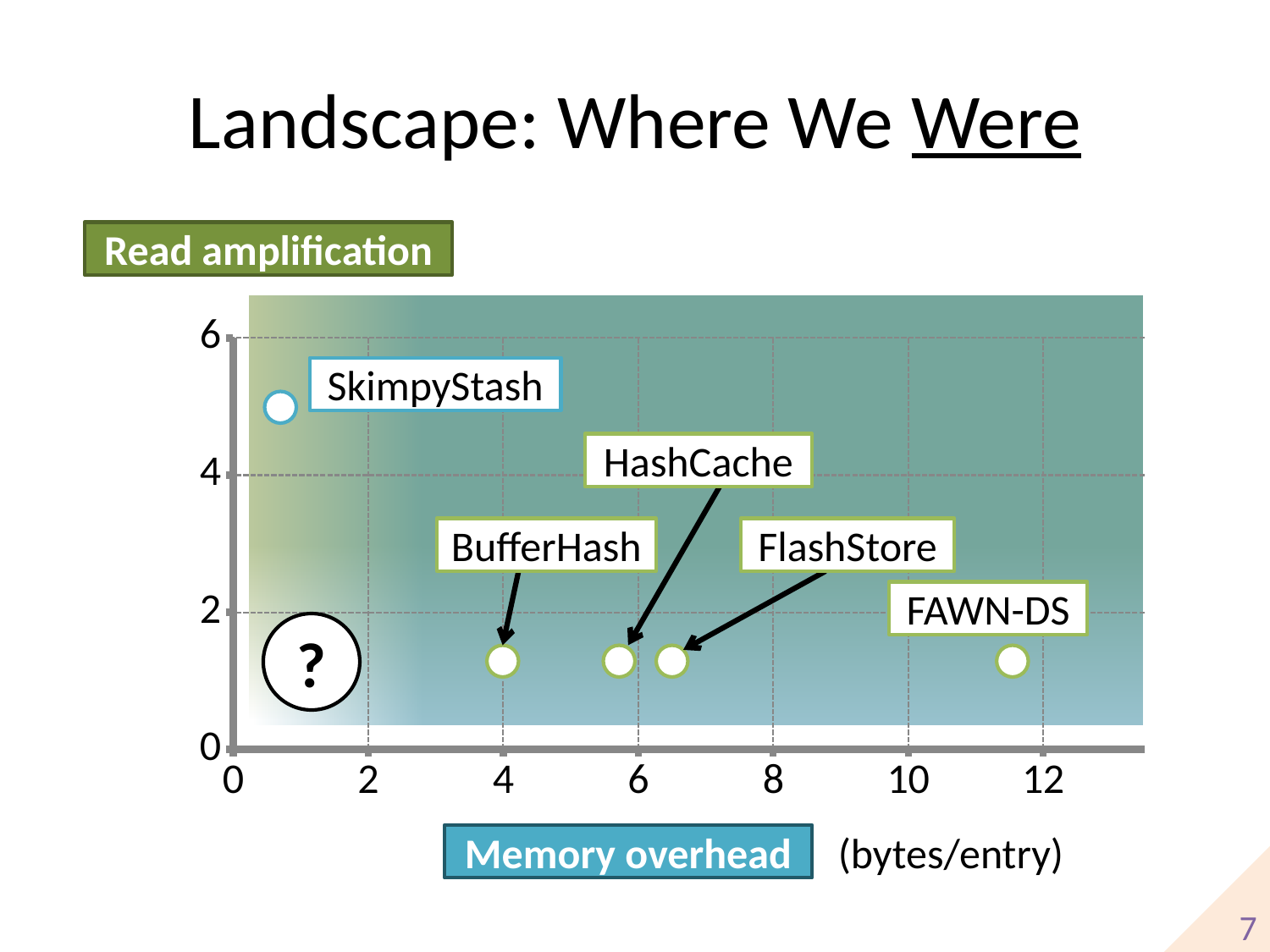
Is the memory overhead for FlashStore greater or less than 8? less Is the read amplification for BufferHash greater or less than 2? less Which system has the lowest memory overhead? SkimpyStash Which system has the highest memory overhead? FAWN-DS Which has the larger memory overhead, FAWN-DS or BufferHash? FAWN-DS Is the memory overhead for FAWN-DS greater or less than 10? greater Which has the larger read amplification, SkimpyStash or HashCache? SkimpyStash What kind of chart is shown on the slide? scatter chart Which system has the highest read amplification? SkimpyStash What quantity is plotted on the horizontal axis, and in what units? Memory overhead (bytes/entry) How many named systems are plotted on the chart? 5